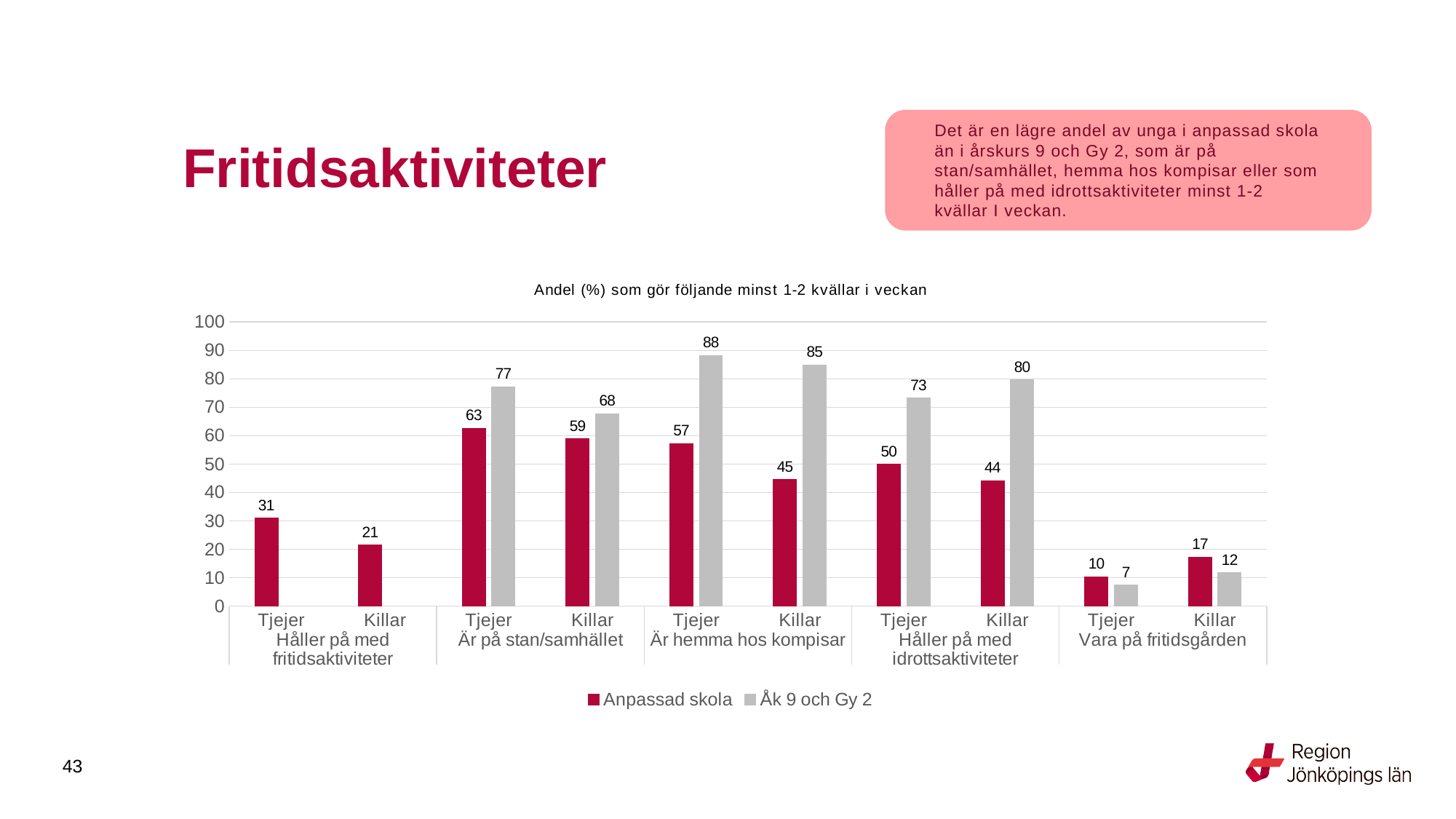
Which bar has the lowest value in the chart? Åk 9 och Gy 2, Tjejer, Vara på fritidsgården (7) What is the value for Anpassad skola for Killar under 'Håller på med fritidsaktiviteter'? 21 For Tjejer under 'Vara på fritidsgården', which series has the larger value, Anpassad skola or Åk 9 och Gy 2? Anpassad skola What is the title of the chart? Andel (%) som gör följande minst 1-2 kvällar i veckan What is the difference between Åk 9 och Gy 2 and Anpassad skola for Killar under 'Är hemma hos kompisar'? 40 What is the value for Åk 9 och Gy 2 for Killar under 'Är hemma hos kompisar'? 85 Which bar has the highest value in the chart? Åk 9 och Gy 2, Tjejer, Är hemma hos kompisar (88) How many activity groups are shown along the x axis? 5 How many series does the legend list? 2 What kind of chart is shown on the slide? Bar chart Is the value for Åk 9 och Gy 2 for Killar under 'Håller på med idrottsaktiviteter' greater or less than 70? greater What is the value for Anpassad skola for Tjejer under 'Är på stan/samhället'? 63